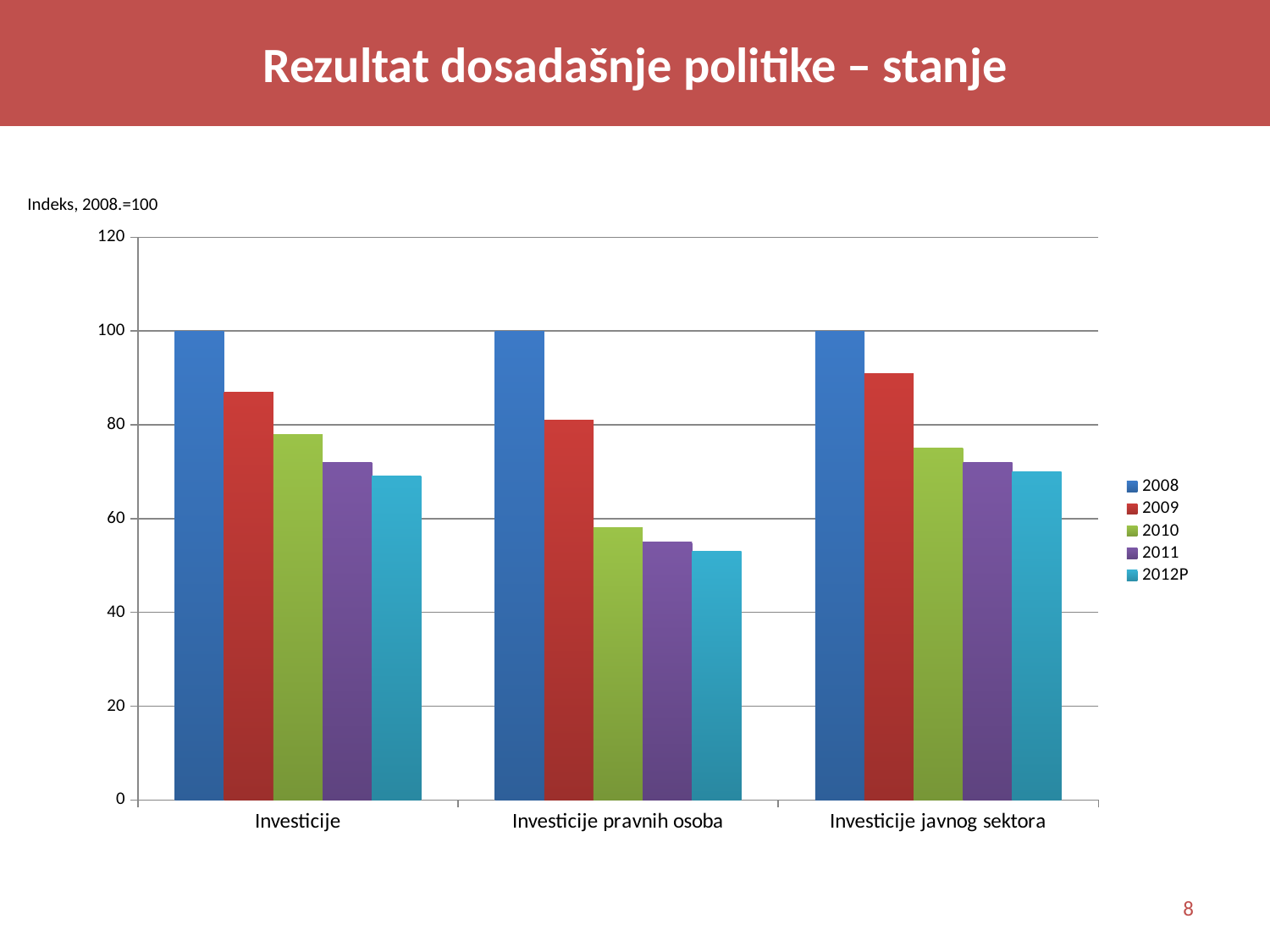
Is the value for 2012P in the Investicije category greater or less than 80? less Which is larger: the 2012P value for Investicije pravnih osoba or the 2012P value for Investicije javnog sektora? Investicije javnog sektora Which category has the lowest value for 2012P? Investicije pravnih osoba Is the value for 2009 in the Investicije javnog sektora category greater or less than 80? greater What note is printed above the chart describing the index base? Indeks, 2008.=100 How many categories are shown on the x axis? 3 Within the Investicije category, do the values rise or fall from 2008 to 2012P? fall What is the value for 2008 in the Investicije category? 100 How many series does the legend list? 5 Is the value for 2012P in the Investicije pravnih osoba category greater or less than 60? less What kind of chart is shown on the slide? bar chart What is the value for 2008 in the Investicije javnog sektora category? 100